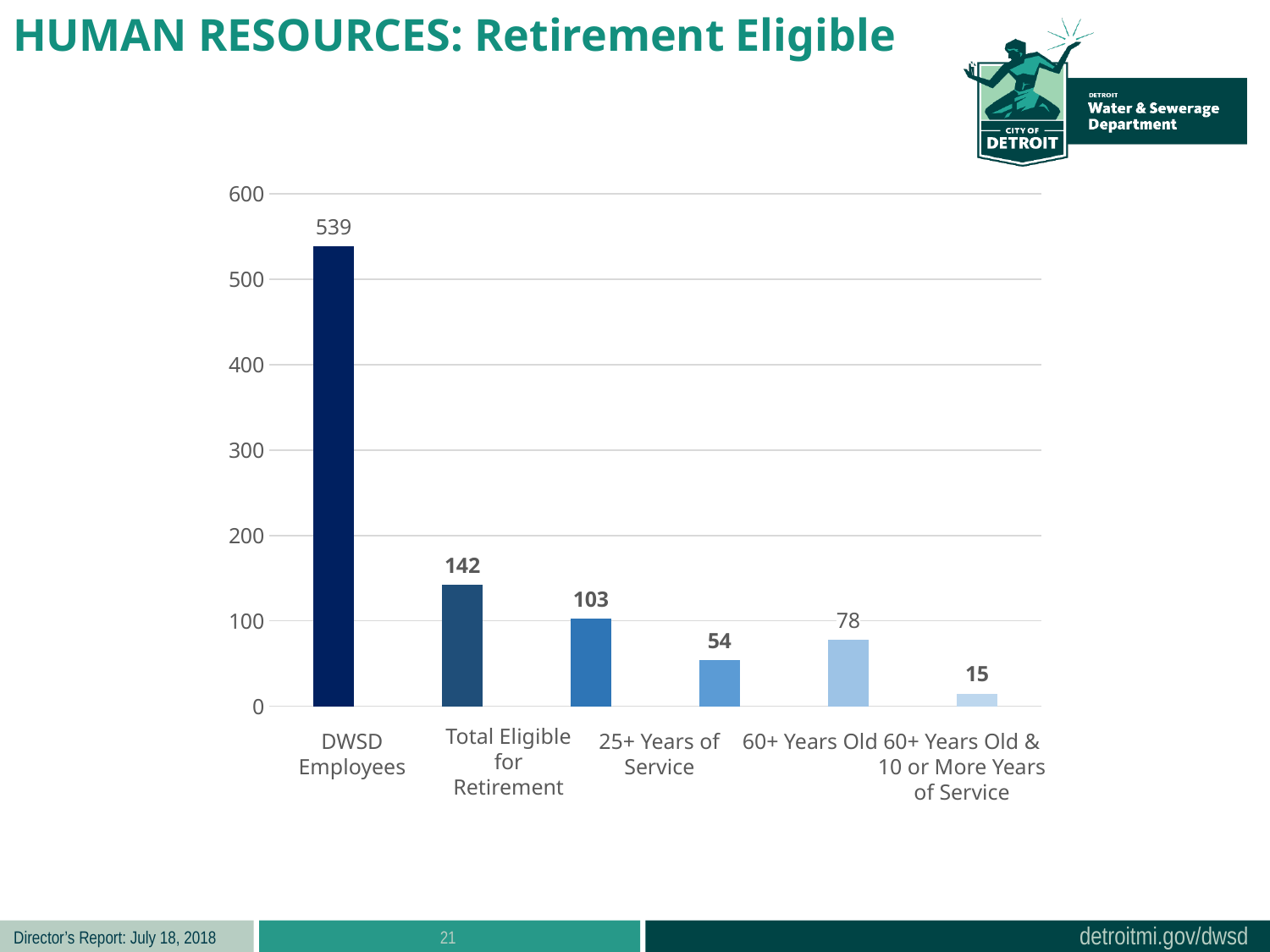
Which category has the highest value? DWSD Employees Is the value for 60+ Years Old greater or less than 100? less What is the value for 60+ Years Old & 10 or More Years of Service? 15 What is the difference between the values for DWSD Employees and Total Eligible for Retirement? 397 What is the value for 25+ Years of Service? 103 What is the difference between the values for 60+ Years Old and 25+ Years of Service? 25 What is the value for Total Eligible for Retirement? 142 What is the value for DWSD Employees? 539 Which category has the lowest value? 60+ Years Old & 10 or More Years of Service How many categories are shown on the chart? 6 What kind of chart is shown on the slide? bar chart Which is larger, the value for 60+ Years Old or the value for 25+ Years of Service? 25+ Years of Service